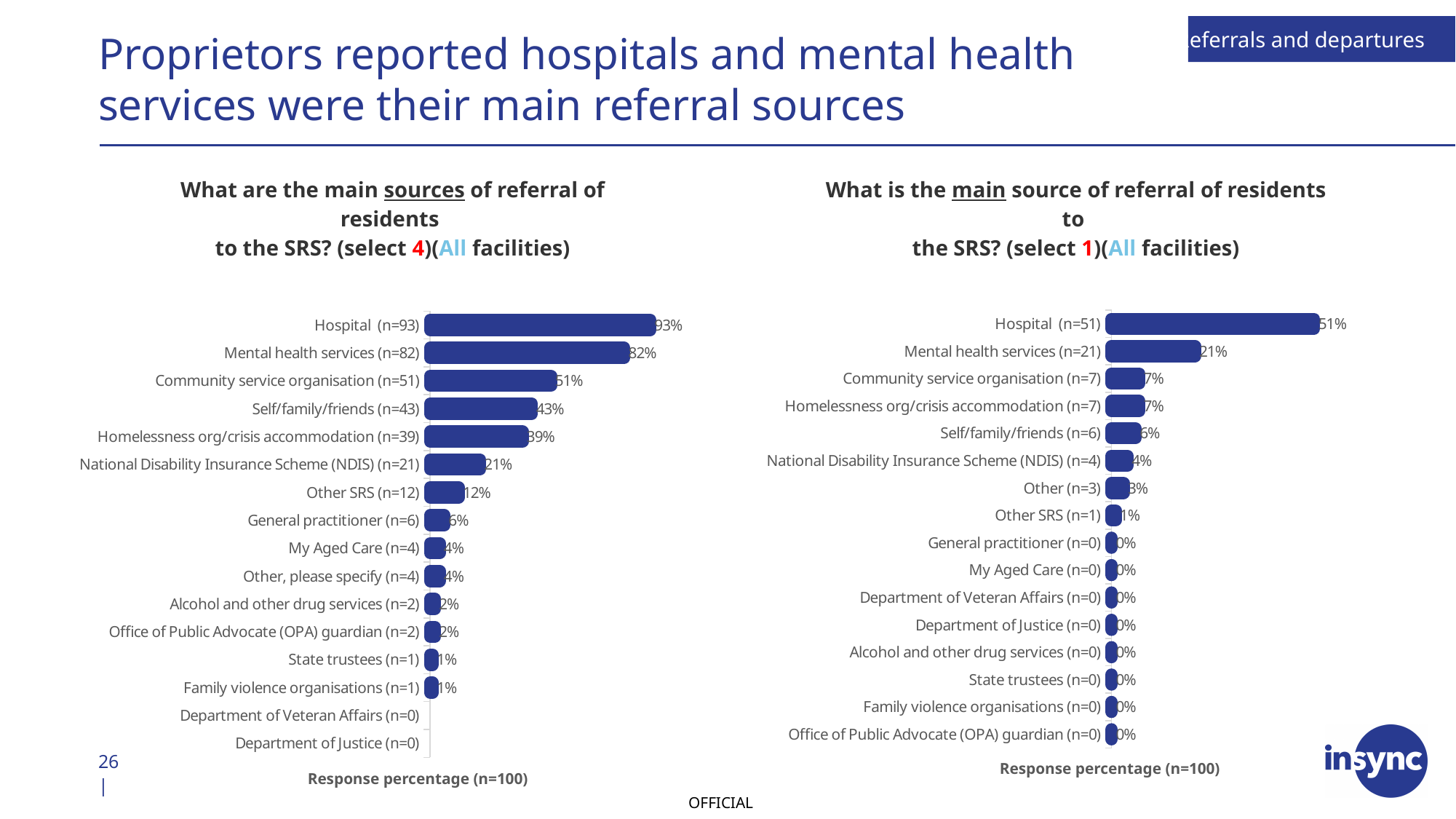
In the left chart (select 4), which is larger: Self/family/friends or National Disability Insurance Scheme (NDIS)? Self/family/friends In the left chart (select 4), what is the difference between Hospital and Mental health services? 11% What kind of chart is the right chart (select 1)? Bar chart What is the x-axis label of the left chart (select 4)? Response percentage (n=100) In the right chart (select 1), which is larger: Self/family/friends or Other SRS? Self/family/friends In the left chart (select 4), what is the value for Hospital? 93% In the right chart (select 1), what is the value for Other? 3% How many categories are shown in the left chart (select 4)? 16 In the left chart (select 4), what is the value for Homelessness org/crisis accommodation? 39% In the right chart (select 1), what is the difference between Hospital and Mental health services? 30% In the right chart (select 1), which category has the highest value? Hospital In the right chart (select 1), what is the value for Mental health services? 21%